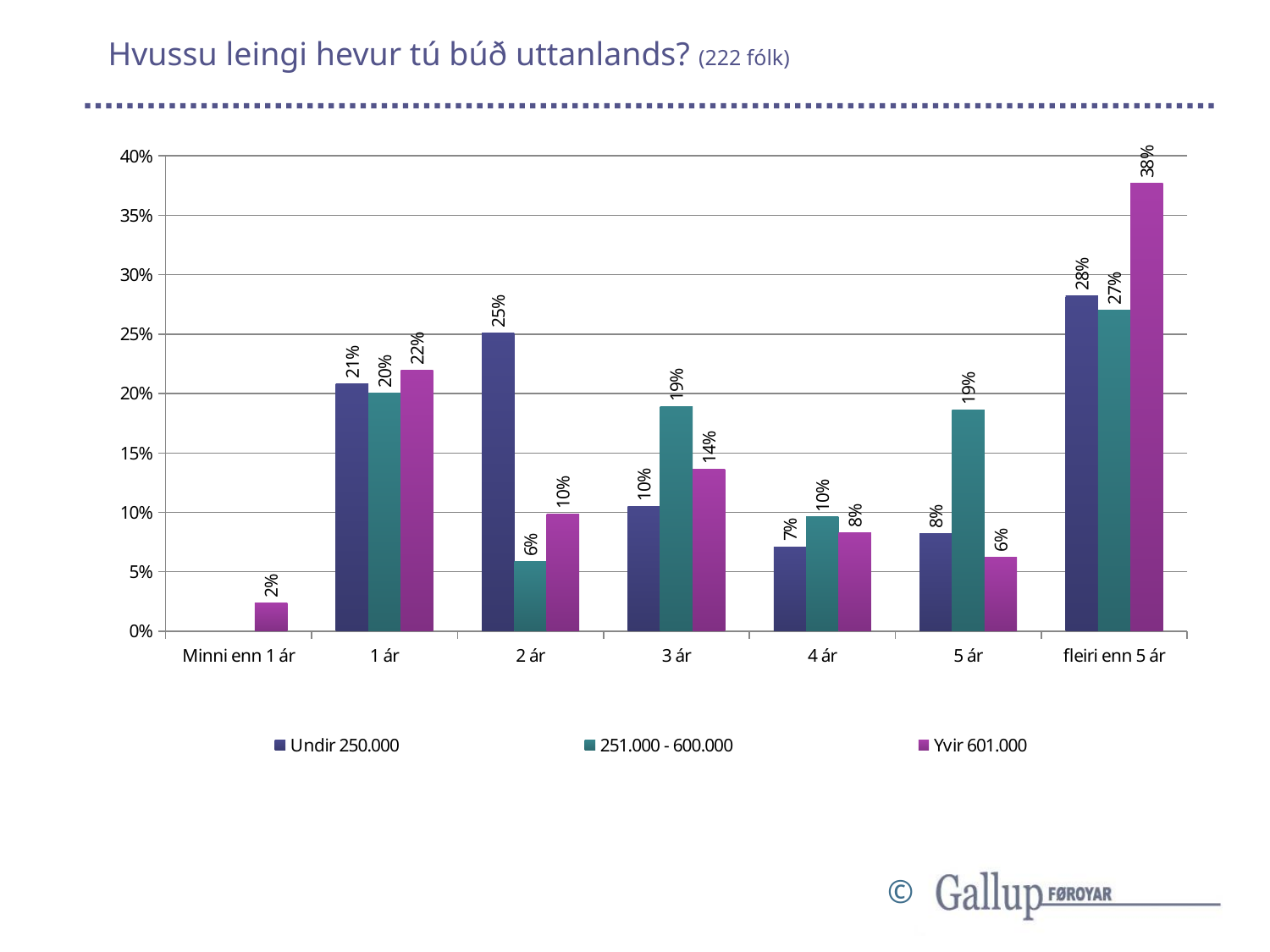
How many categories are shown on the x axis? 7 What is the value for Undir 250.000 in the '2 ár' category? 25% Which category has the highest value for the Undir 250.000 series? fleiri enn 5 ár Which category has the lowest value for the 251.000 - 600.000 series among those with a bar shown? 2 ár In the '3 ár' category, which series has the larger value: Undir 250.000 or 251.000 - 600.000? 251.000 - 600.000 What kind of chart is shown on the slide? Bar chart What is the value for Yvir 601.000 in the 'fleiri enn 5 ár' category? 38% What is the difference between the Yvir 601.000 and Undir 250.000 values in the 'fleiri enn 5 ár' category? 10% What is the value for Yvir 601.000 in the 'Minni enn 1 ár' category? 2% How many series does the legend list? 3 How many people (fólk) are mentioned in the chart title? 222 What is the value for 251.000 - 600.000 in the '5 ár' category? 19%